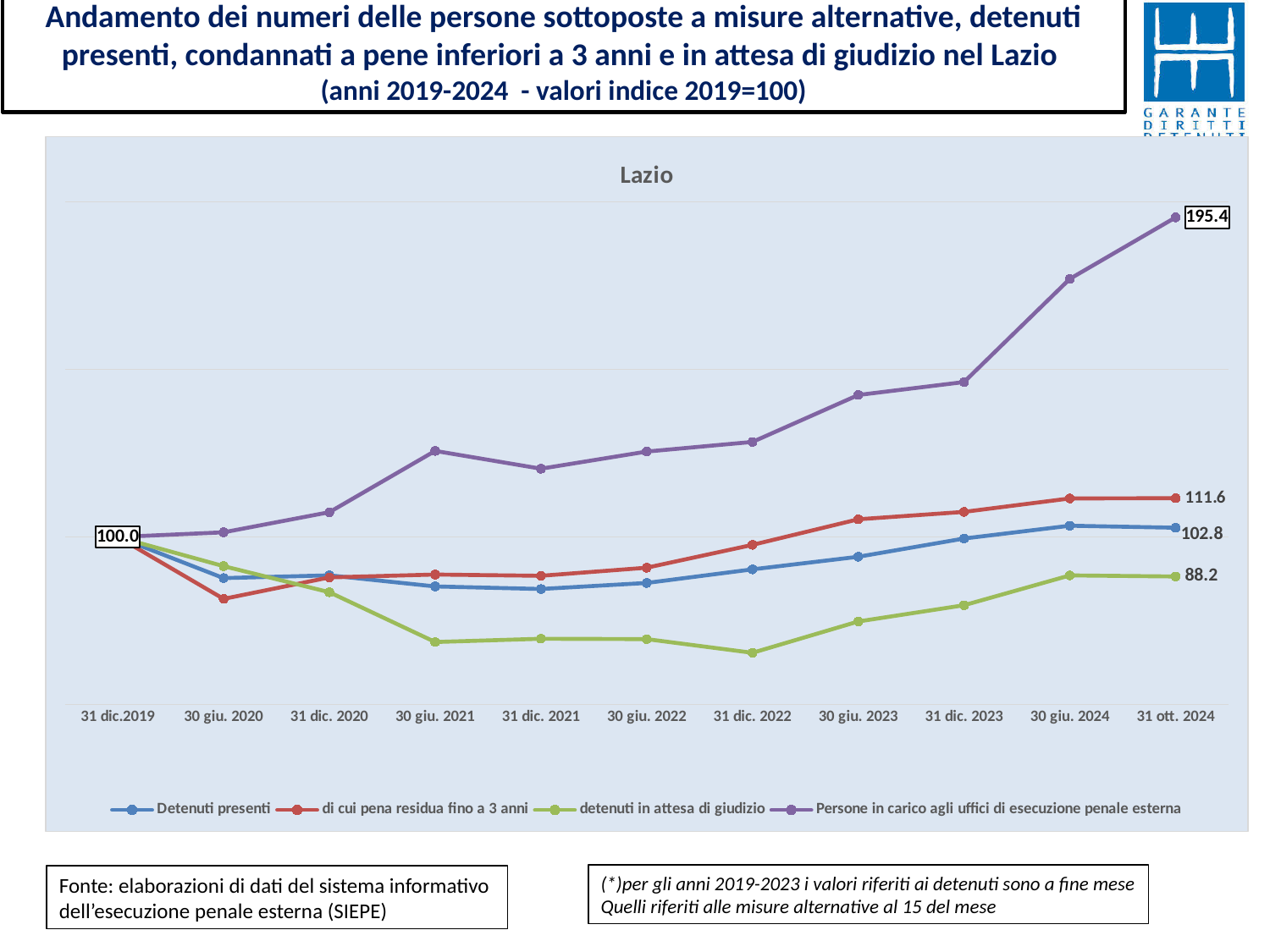
What is the value for 'di cui pena residua fino a 3 anni' at 31 ott. 2024? 111.6 How many series does the legend list? 4 What is the value for 'Persone in carico agli uffici di esecuzione penale esterna' at 31 ott. 2024? 195.4 Which series has the lowest value at 31 ott. 2024? detenuti in attesa di giudizio What is the value for 'Detenuti presenti' at 31 ott. 2024? 102.8 How many dates are shown along the x axis? 11 Which series has the highest value at 31 ott. 2024? Persone in carico agli uffici di esecuzione penale esterna Does the 'Persone in carico agli uffici di esecuzione penale esterna' series rise or fall from 31 dic.2019 to 31 ott. 2024? rise What is the value for 'detenuti in attesa di giudizio' at 31 ott. 2024? 88.2 What is the difference between the values of 'Persone in carico agli uffici di esecuzione penale esterna' and 'detenuti in attesa di giudizio' at 31 ott. 2024? 107.2 What is the index value shown for all series at 31 dic.2019? 100.0 What kind of chart is shown on the slide? line chart